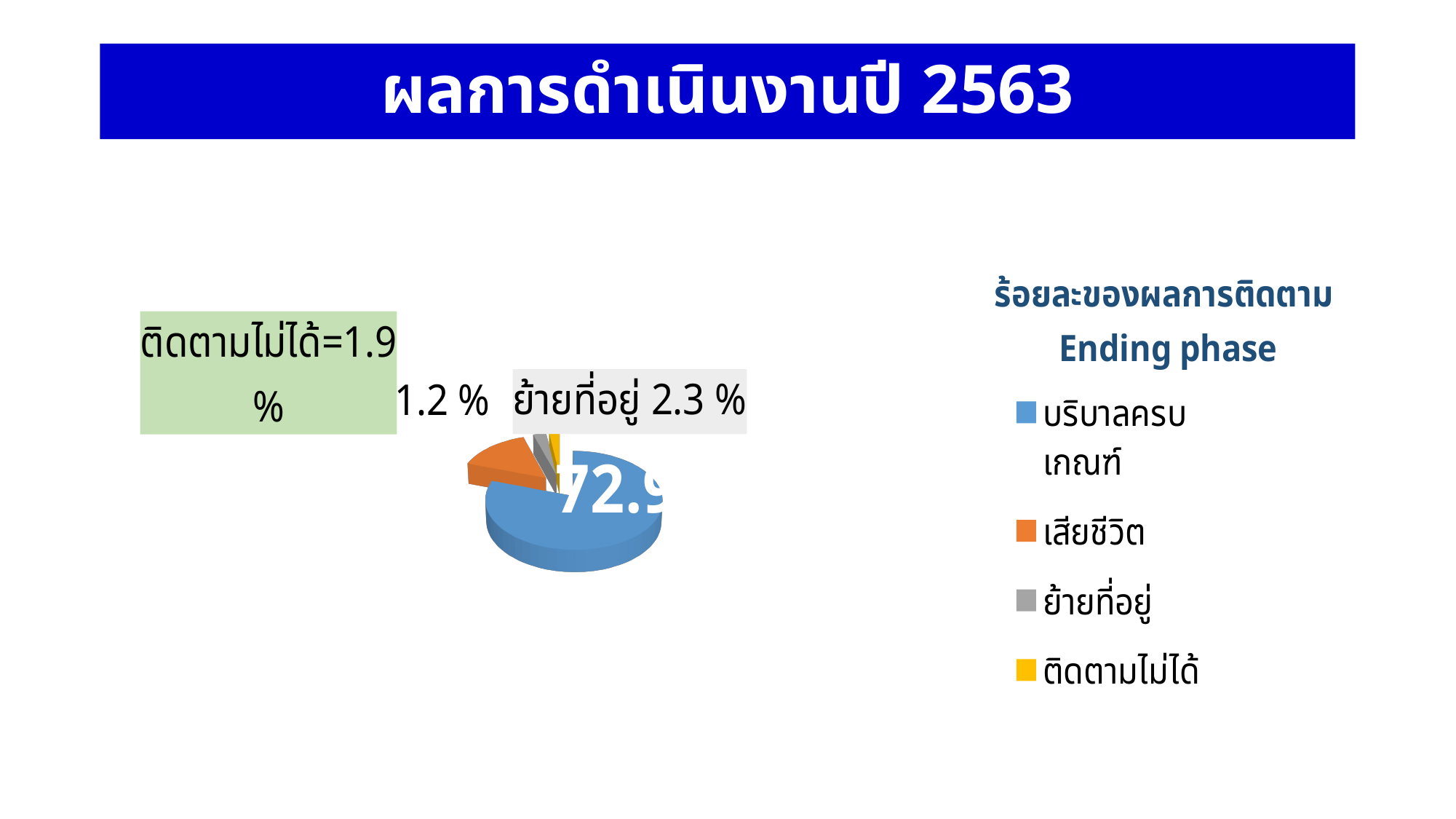
Which category is shown in blue in the pie chart? บริบาลครบเกณฑ์ Which category has the largest slice in the pie chart? บริบาลครบเกณฑ์ Which colour represents เสียชีวิต in the pie chart? orange Which is larger in the pie chart, ย้ายที่อยู่ or ติดตามไม่ได้? ย้ายที่อยู่ What is the difference between the percentages for ย้ายที่อยู่ and ติดตามไม่ได้? 0.4 % What is the title of the pie chart? ร้อยละของผลการติดตาม Ending phase What kind of chart is shown on the slide? pie chart What percentage is shown for ย้ายที่อยู่ in the pie chart? 2.3 % How many categories does the legend of the pie chart list? 4 What percentage is shown for ติดตามไม่ได้ in the pie chart? 1.9 %